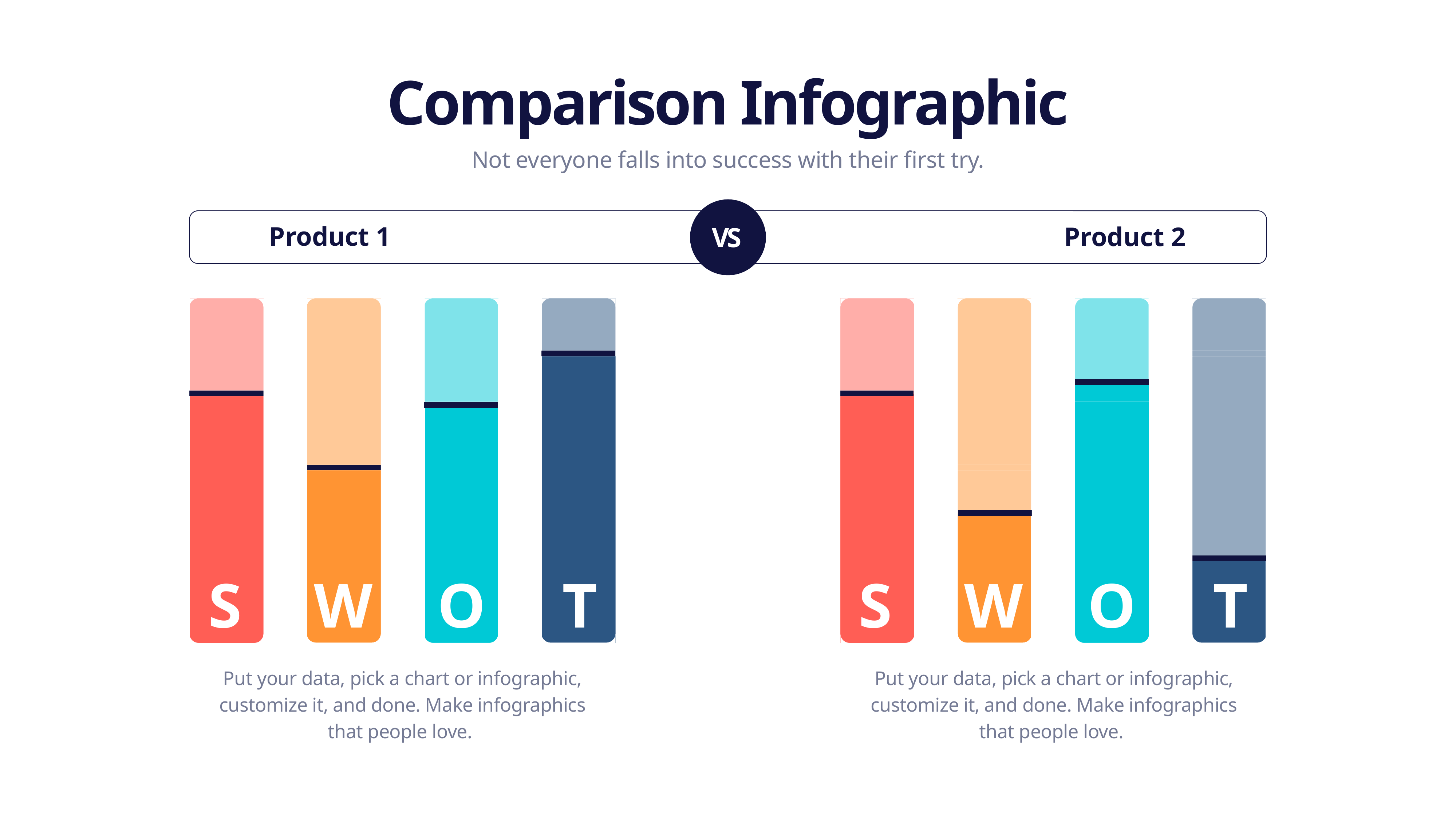
In the Product 2 chart, which bar is filled the lowest? T How many bars are in the Product 2 chart? 4 In the Product 2 chart, which bar is filled higher, O or T? O What colour is the filled portion of the S bar in the Product 2 chart? red In the Product 2 chart, which bar is filled higher, S or W? S What kind of chart is shown under Product 1? bar chart In the Product 1 chart, which bar is filled the lowest? W Which chart has the higher fill for the T bar, Product 1 or Product 2? Product 1 What letters label the four bars in the Product 1 chart, from left to right? S, W, O, T In the Product 1 chart, which bar is filled the highest? T How many bars are in the Product 1 chart? 4